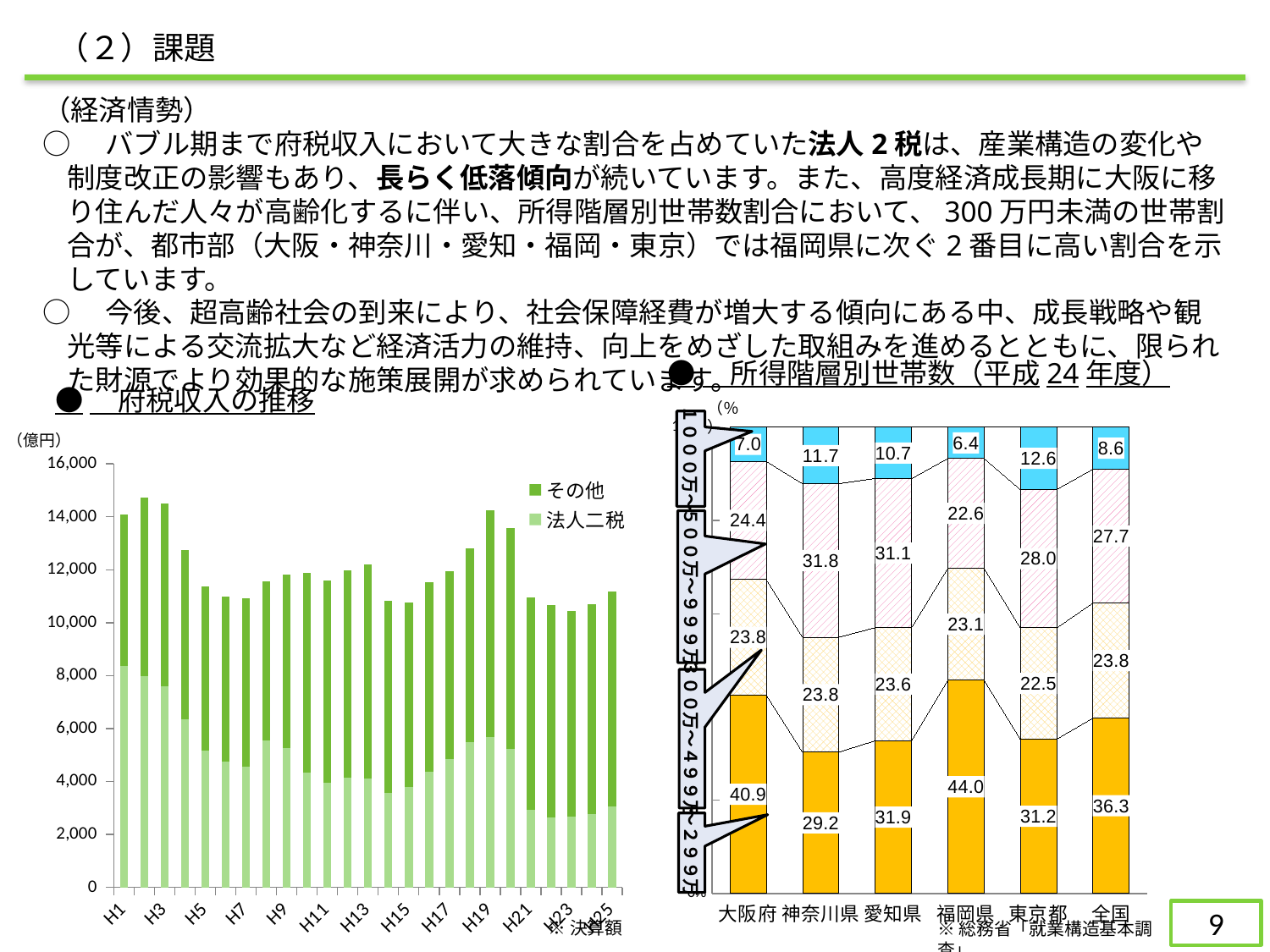
In the right chart (所得階層別世帯数), what is the difference between the ~299万 values for 福岡県 and 大阪府? 3.1 In the right chart (所得階層別世帯数), what is the value of the top (1000万~) segment for 東京都? 12.6 In the right chart (所得階層別世帯数), which is larger: the 500万~999万 value for 愛知県 or for 全国? 愛知県 In the right chart (所得階層別世帯数), what is the value of the 500万~999万 segment for 神奈川県? 31.8 In the right chart (所得階層別世帯数), what is the value of the bottom (~299万) segment for 大阪府? 40.9 In the right chart (所得階層別世帯数), which category has the lowest value for the top (1000万~) segment? 福岡県 In the left chart (府税収入の推移), is the total value for H2 greater or less than 14,000? greater In the left chart (府税収入の推移), is the total value for H22 greater or less than 12,000? less In the left chart (府税収入の推移), how many series does the legend list? 2 In the right chart (所得階層別世帯数), how many prefecture/region categories are shown on the x axis? 6 What kind of chart is the left chart (府税収入の推移)? stacked bar chart In the right chart (所得階層別世帯数), which prefecture has the highest value for the bottom (~299万) segment? 福岡県